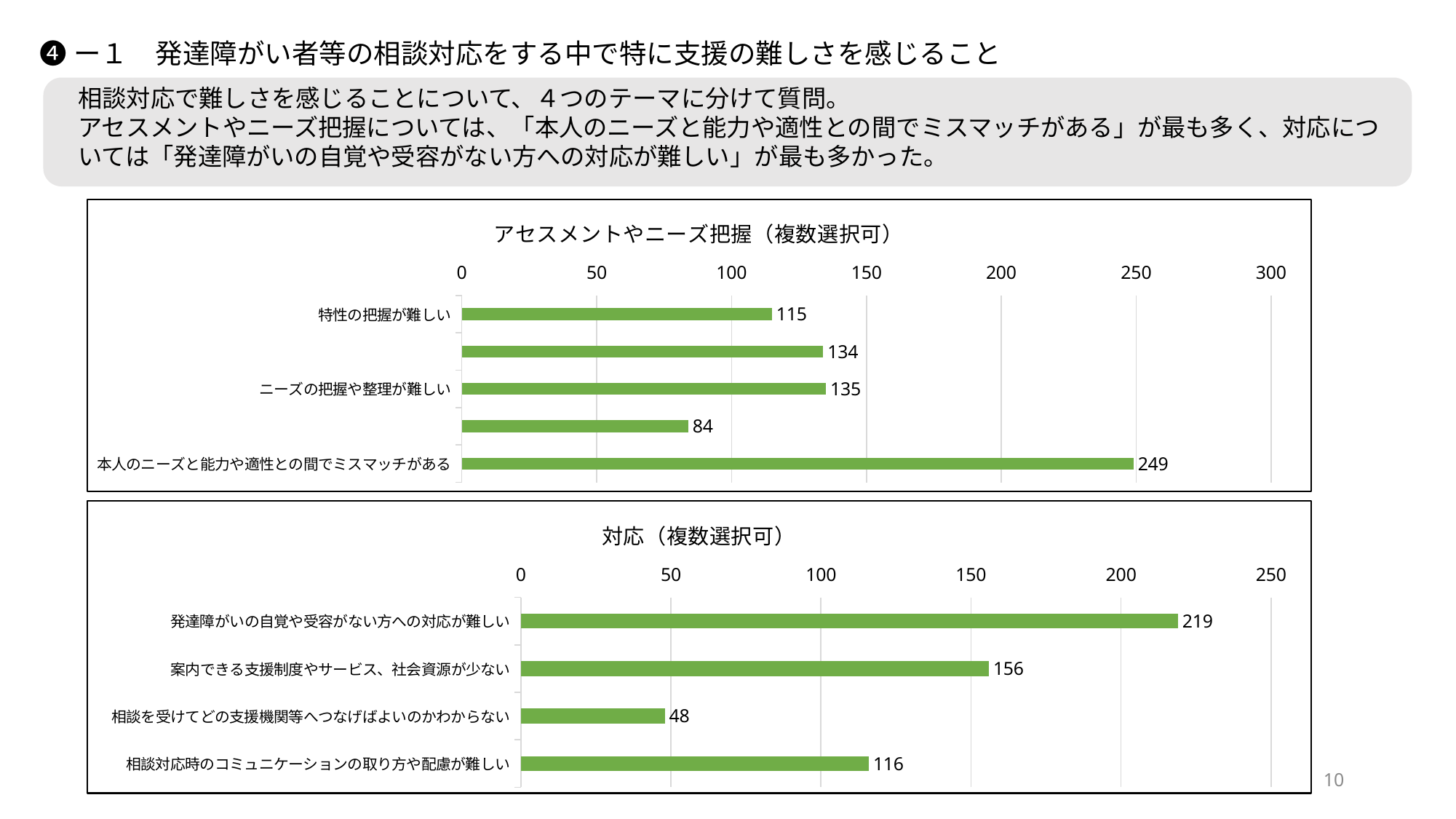
In the chart titled 対応（複数選択可）, which is larger: 相談対応時のコミュニケーションの取り方や配慮が難しい or 相談を受けてどの支援機関等へつなげばよいのかわからない? 相談対応時のコミュニケーションの取り方や配慮が難しい What type of chart is the chart titled 対応（複数選択可）? Bar chart In the chart titled 対応（複数選択可）, which category has the highest value? 発達障がいの自覚や受容がない方への対応が難しい In the chart titled アセスメントやニーズ把握（複数選択可）, what is the value for 本人のニーズと能力や適性との間でミスマッチがある? 249 In the chart titled 対応（複数選択可）, what is the difference between 発達障がいの自覚や受容がない方への対応が難しい and 案内できる支援制度やサービス、社会資源が少ない? 63 In the chart titled アセスメントやニーズ把握（複数選択可）, what is the lowest value shown on any bar? 84 In the chart titled 対応（複数選択可）, which category has the lowest value? 相談を受けてどの支援機関等へつなげばよいのかわからない In the chart titled 対応（複数選択可）, what is the value for 案内できる支援制度やサービス、社会資源が少ない? 156 In the chart titled アセスメントやニーズ把握（複数選択可）, how many bars are plotted? 5 In the chart titled アセスメントやニーズ把握（複数選択可）, what is the difference between 本人のニーズと能力や適性との間でミスマッチがある and ニーズの把握や整理が難しい? 114 In the chart titled アセスメントやニーズ把握（複数選択可）, what is the value for 特性の把握が難しい? 115 In the chart titled アセスメントやニーズ把握（複数選択可）, which category has the highest value? 本人のニーズと能力や適性との間でミスマッチがある